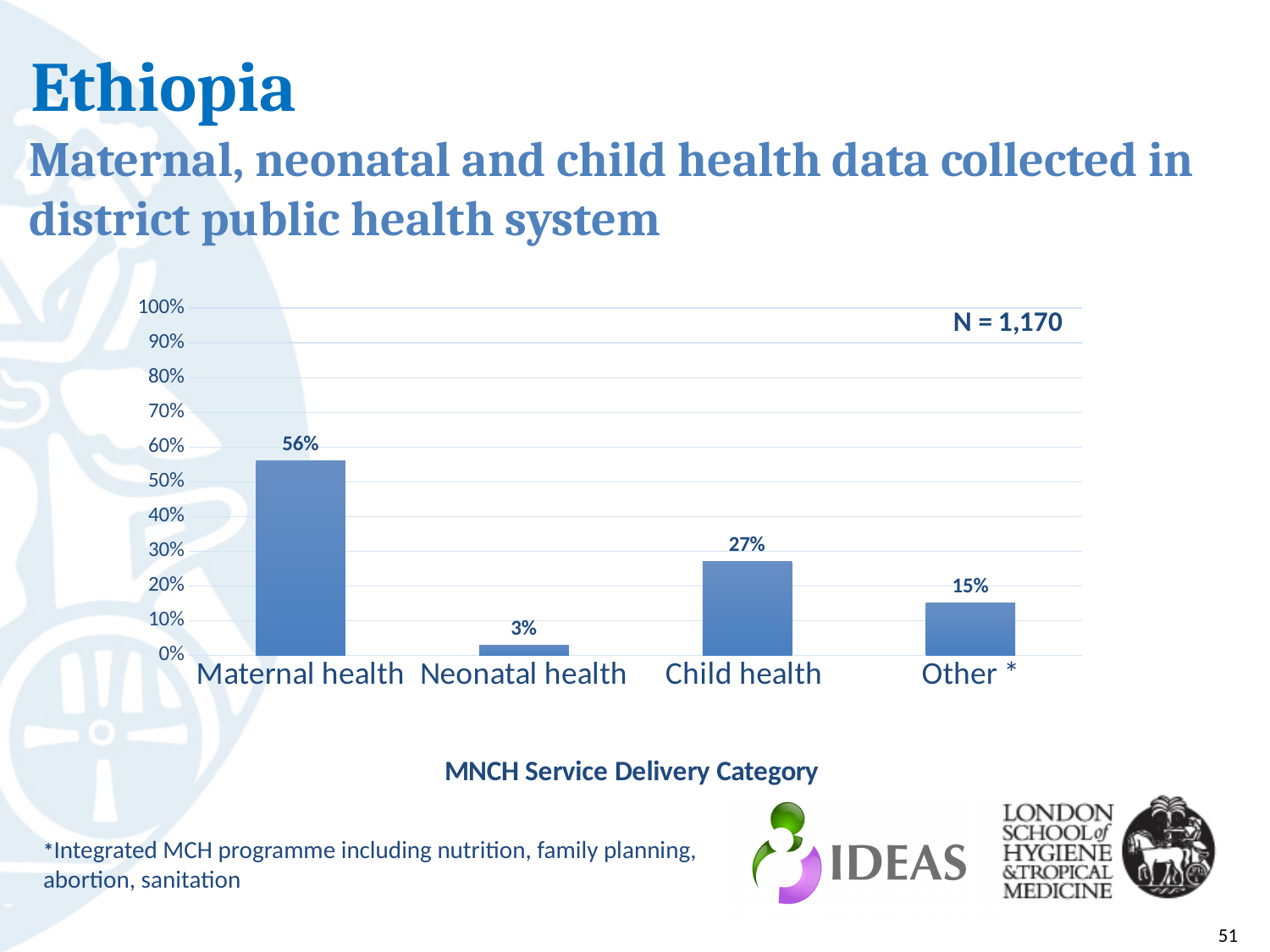
Which category has the lowest percentage? Neonatal health What is the x-axis title of the chart? MNCH Service Delivery Category What percentage is shown for Neonatal health? 3% Is the value for Maternal health greater or less than 50%? greater Which is larger, the value for Child health or the value for Other *? Child health How many categories are shown on the x axis? 4 What percentage is shown for Other *? 15% What is the difference between the Maternal health and Child health percentages? 29% What kind of chart is shown on the slide? bar chart What percentage is shown for Maternal health? 56% What percentage is shown for Child health? 27% Which category has the highest percentage? Maternal health